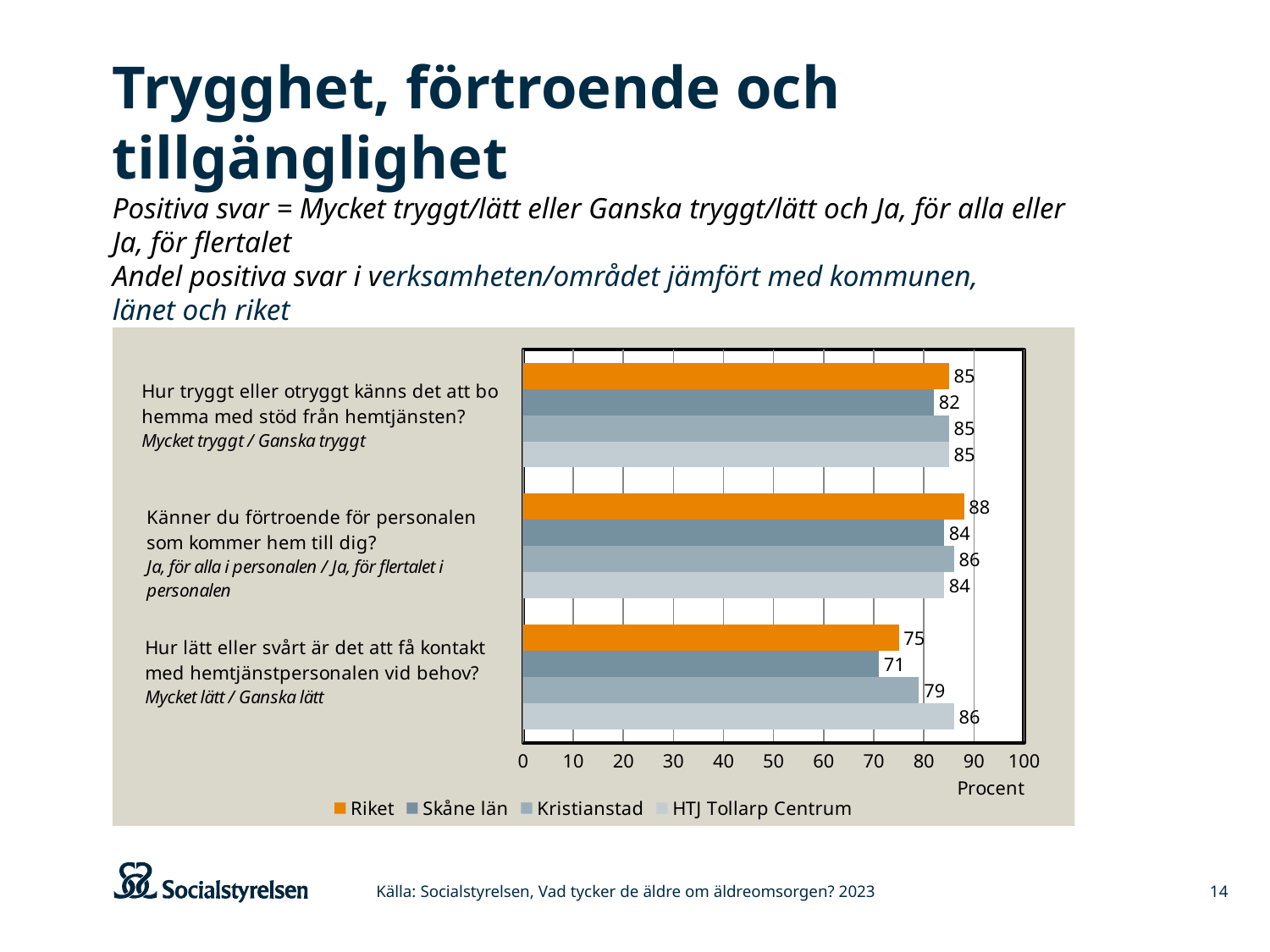
Which series has the lowest value on the question "Hur lätt eller svårt är det att få kontakt med hemtjänstpersonalen vid behov?"? Skåne län What is the value for Skåne län on the question "Hur tryggt eller otryggt känns det att bo hemma med stöd från hemtjänsten?"? 82 What kind of chart is shown on the slide? Bar chart What is the label of the x axis? Procent Which is larger on the question "Känner du förtroende för personalen som kommer hem till dig?": Kristianstad or HTJ Tollarp Centrum? Kristianstad What is the value for Riket on the question "Känner du förtroende för personalen som kommer hem till dig?"? 88 Is the value for Skåne län on the question "Hur lätt eller svårt är det att få kontakt med hemtjänstpersonalen vid behov?" greater or less than 80? less What is the value for HTJ Tollarp Centrum on the question "Hur lätt eller svårt är det att få kontakt med hemtjänstpersonalen vid behov?"? 86 How many series does the legend list? 4 How many question categories are plotted on the chart? 3 Which series has the highest value on the question "Känner du förtroende för personalen som kommer hem till dig?"? Riket What is the difference between HTJ Tollarp Centrum and Riket on the question "Hur lätt eller svårt är det att få kontakt med hemtjänstpersonalen vid behov?"? 11